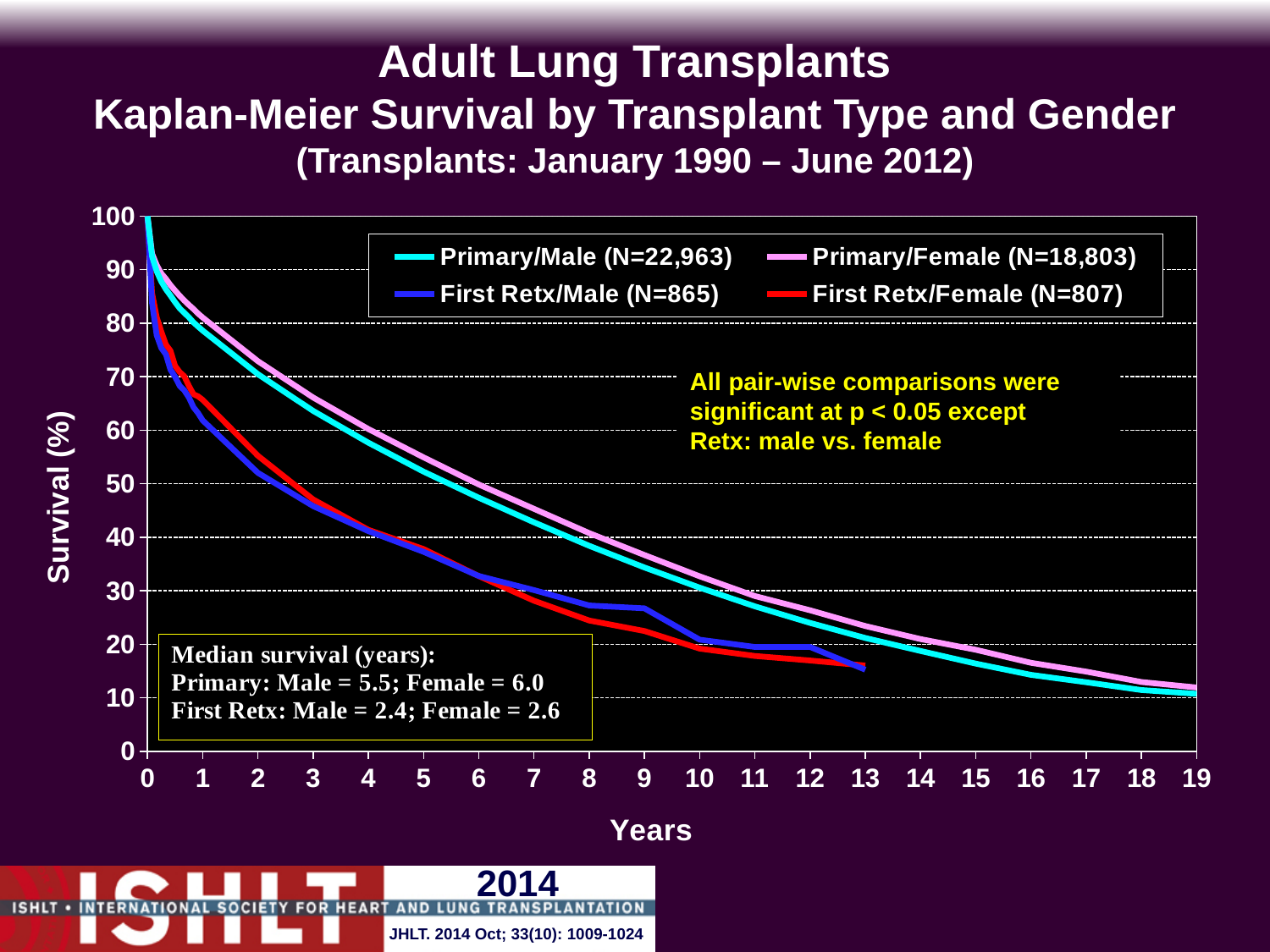
What is the N for the Primary/Male group shown in the legend? 22,963 Which group has the lowest median survival? First Retx Male (2.4 years) How many series does the legend list? 4 What is the N for the First Retx/Female group shown in the legend? 807 At 5 years, which curve is higher: Primary/Female or Primary/Male? Primary/Female What is the median survival in years for First Retx Male transplants? 2.4 What is the median survival in years for Primary Female transplants? 6.0 What kind of chart is shown on the slide? Line chart Which group has the highest median survival? Primary Female (6.0 years) Is the survival for Primary/Male at 15 years greater or less than 20%? less Is the survival for Primary/Female at 5 years greater or less than 50%? greater What is the difference in median survival between Primary Female and Primary Male? 0.5 years